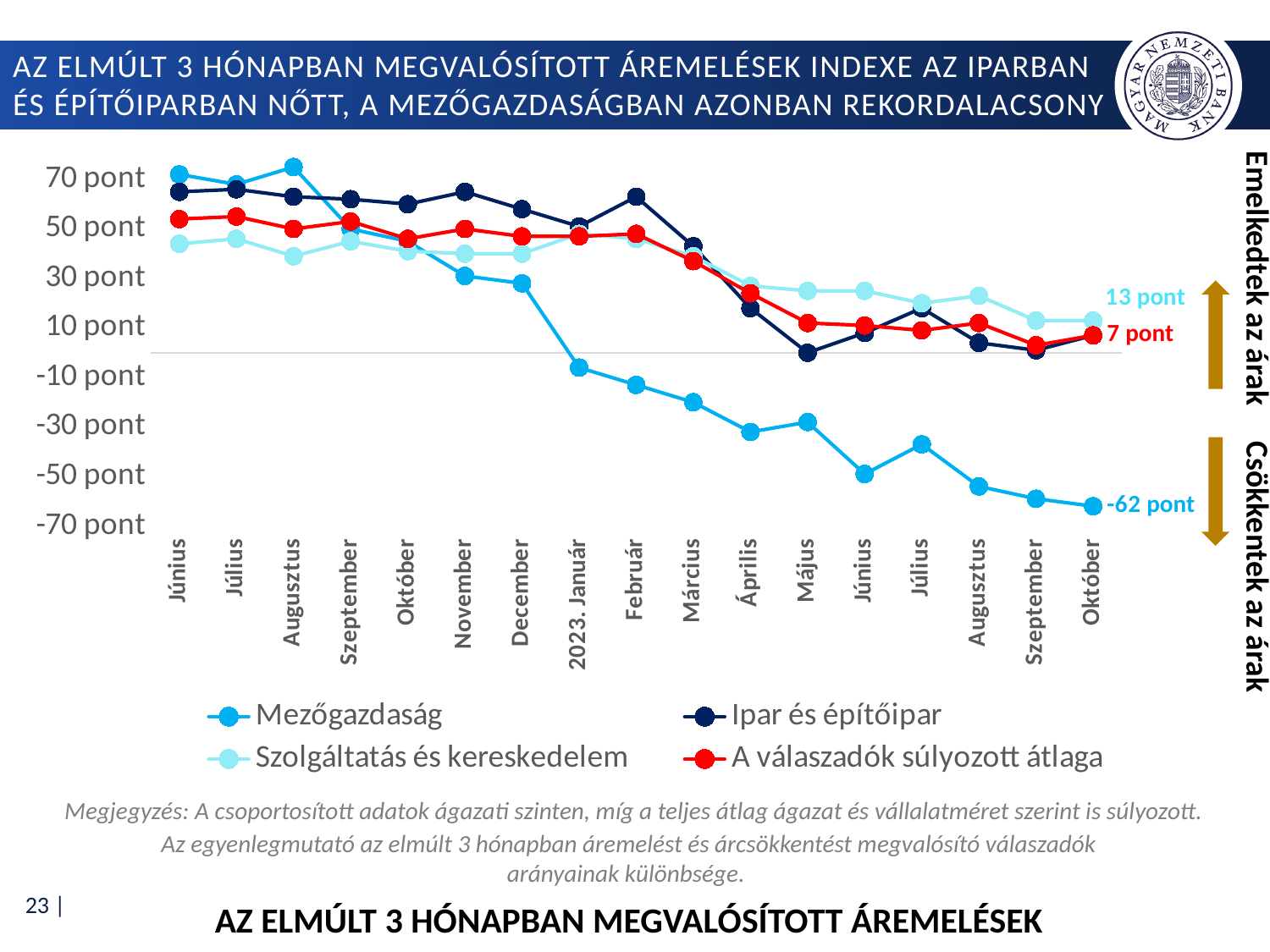
How many series does the legend list? 4 At the final Október point, which is larger: Szolgáltatás és kereskedelem or A válaszadók súlyozott átlaga? Szolgáltatás és kereskedelem Which series has the lowest value at the final Október point? Mezőgazdaság What is the title printed below the chart? AZ ELMÚLT 3 HÓNAPBAN MEGVALÓSÍTOTT ÁREMELÉSEK What is the value for Szolgáltatás és kereskedelem at the final Október point? 13 pont Does the Mezőgazdaság series rise or fall from the first Június to the final Október? fall Is the value for Mezőgazdaság in Május greater or less than -10 pont? less What is the value for Mezőgazdaság at the final Október point? -62 pont What is the value for A válaszadók súlyozott átlaga at the final Október point? 7 pont How many months are shown along the x axis? 17 What kind of chart is shown on the slide? line chart What is the difference between the final Október values of Szolgáltatás és kereskedelem and Mezőgazdaság? 75 pont